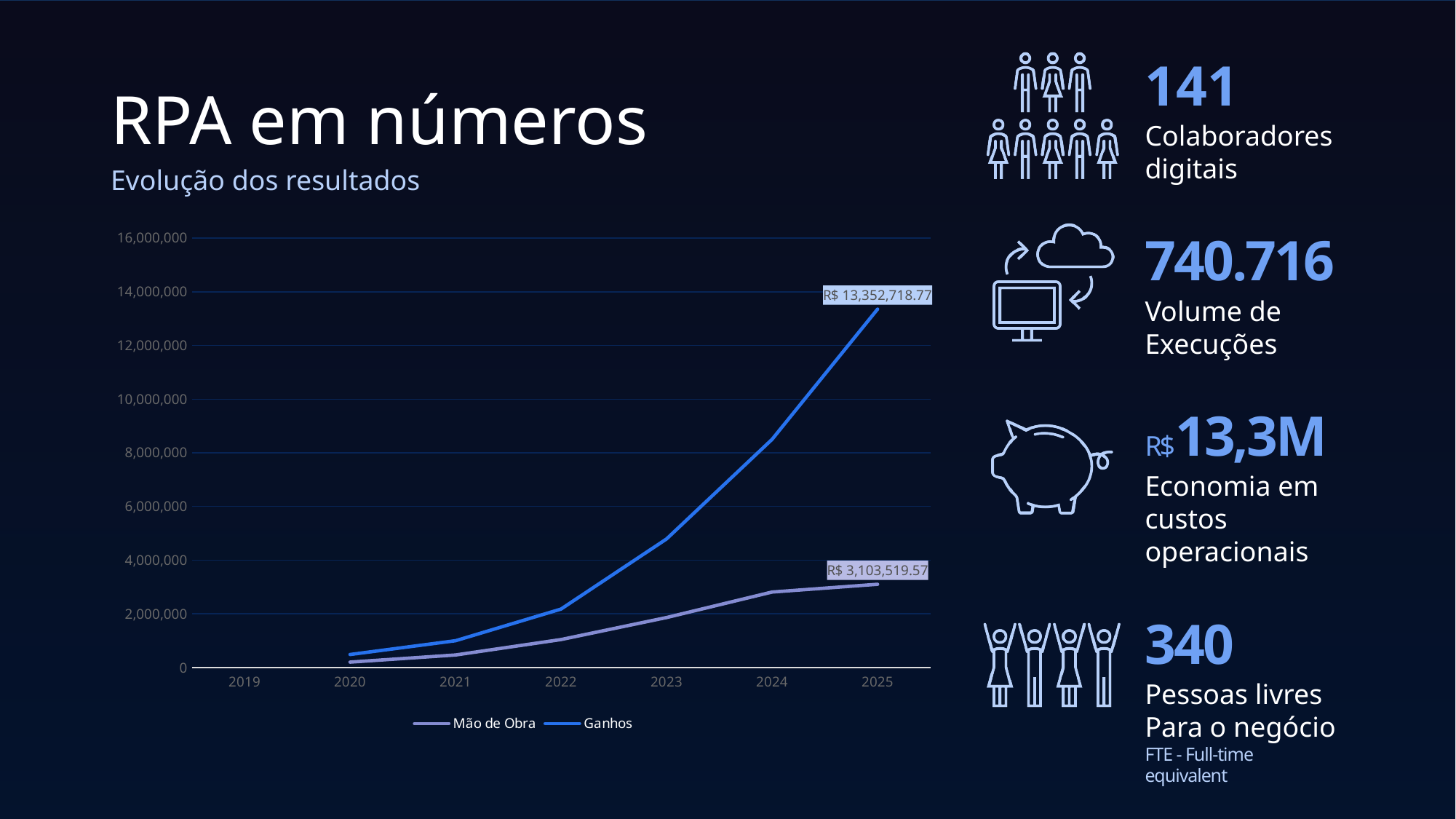
What are the two series names shown in the chart legend? Mão de Obra and Ganhos What is the value of the Mão de Obra series in 2025? R$ 3,103,519.57 Is the Ganhos value for 2024 greater or less than 6,000,000? greater Is the Mão de Obra value for 2024 greater or less than 4,000,000? less Is the Ganhos value for 2023 greater or less than 4,000,000? greater What kind of chart is shown on the slide? line chart What is the difference between the Ganhos and Mão de Obra values in 2025? R$ 10,249,199.20 How many series does the chart legend list? 2 In 2025, which series has the larger value, Ganhos or Mão de Obra? Ganhos In which year does the Ganhos series reach its highest value? 2025 Does the Ganhos series rise or fall from 2020 to 2025? rise What is the value of the Ganhos series in 2025? R$ 13,352,718.77